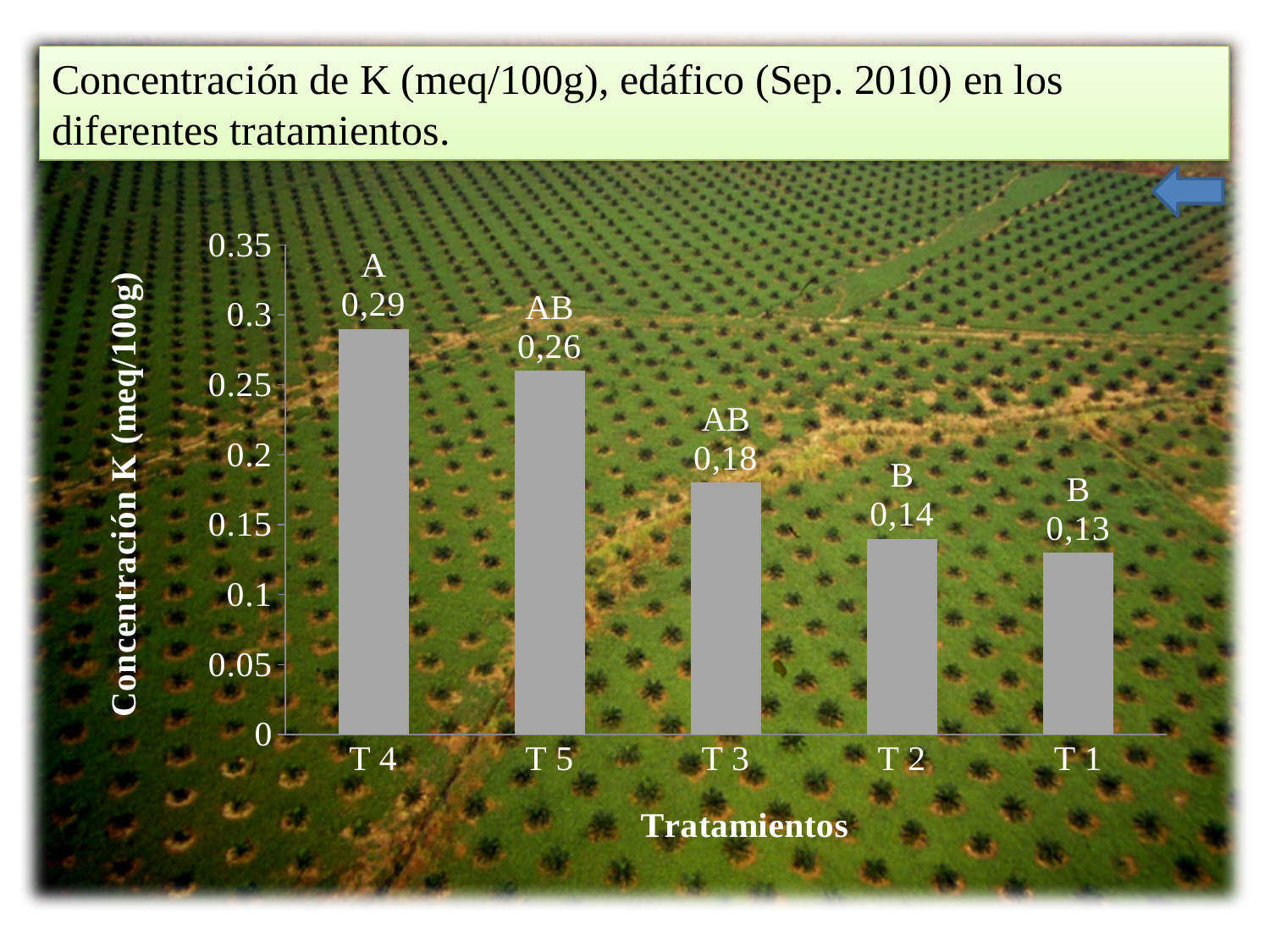
Do the K concentration values rise or fall from left to right along the x axis? Fall Which treatment has the highest K concentration? T 4 What is the K concentration value for treatment T 1? 0,13 What is the difference between the K concentration of T 3 and T 2? 0,04 How many treatments are shown on the x axis? 5 Which treatment has the lowest K concentration? T 1 What kind of chart is shown on the slide? Bar chart Which has a larger K concentration, T 5 or T 3? T 5 What is the K concentration value for treatment T 3? 0,18 What is the difference between the K concentration of T 4 and T 5? 0,03 What statistical group letter is shown above the bar for T 4? A What is the K concentration value for treatment T 4? 0,29